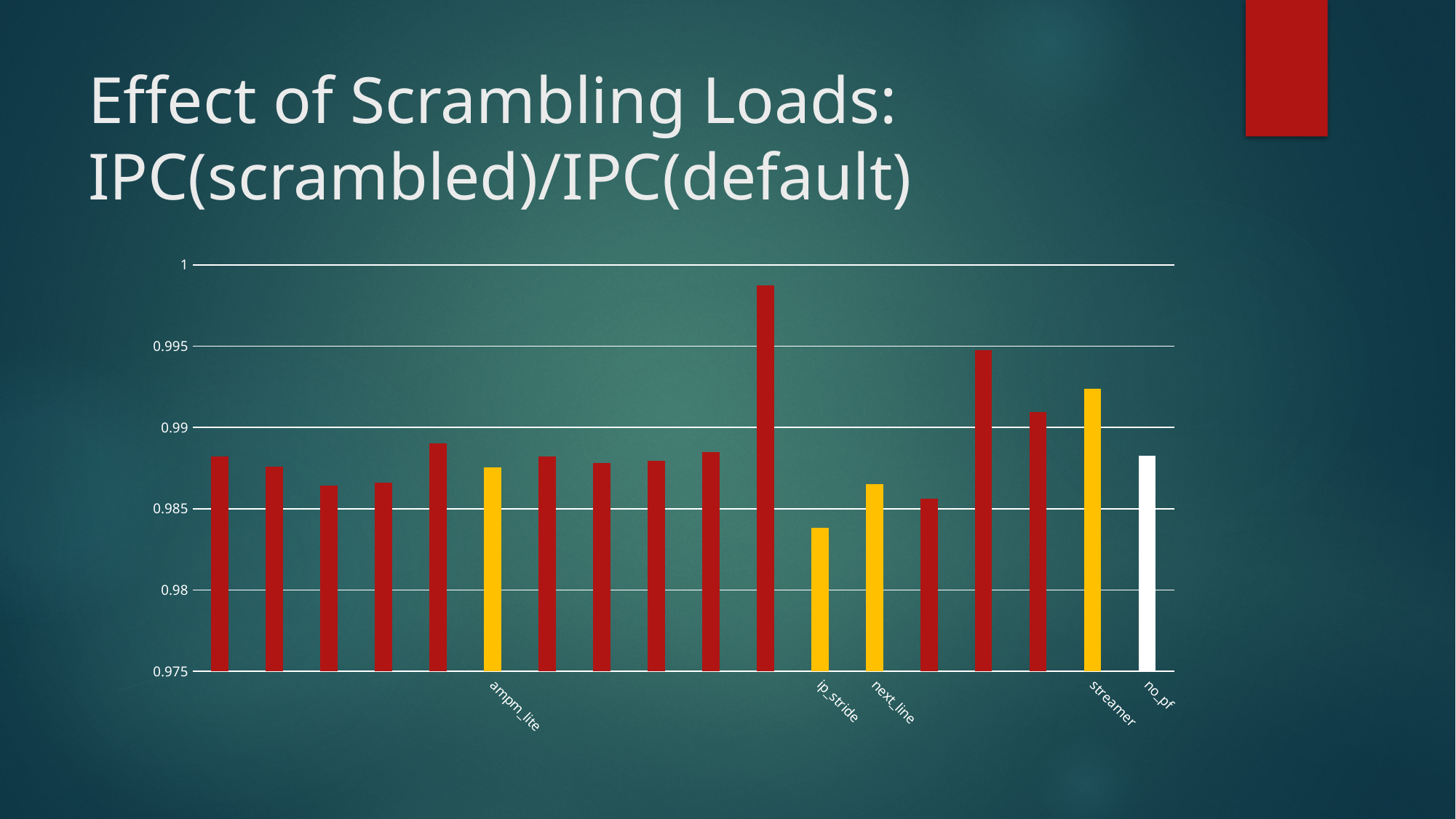
What is the highest value shown on the vertical axis? 1 Is the value for streamer greater or less than 0.99? greater Which has the larger value, streamer or ip_stride? streamer What kind of chart is shown on the slide? bar chart Which bar has the lowest value in the chart? ip_stride What colour is the bar for no_pf? white Is the value for ampm_lite greater or less than 0.985? greater How many bars are plotted in the chart? 18 Is the value for next_line greater or less than 0.985? greater Which has the larger value, no_pf or next_line? no_pf